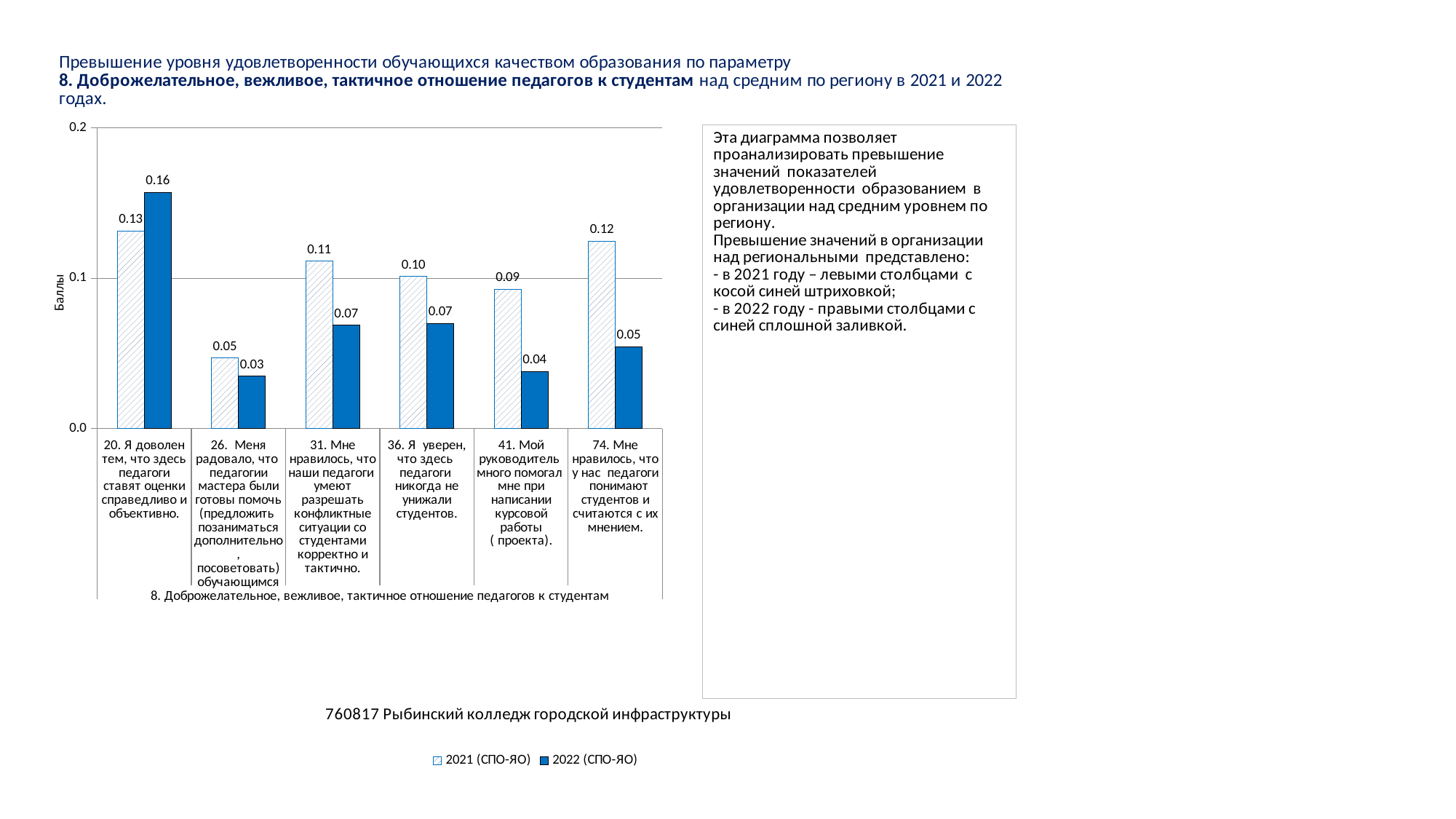
How many categories are shown on the x axis of the chart? 6 What is the 2022 (СПО-ЯО) value for category 41 ("Мой руководитель много помогал мне при написании курсовой работы")? 0.04 What is the 2022 (СПО-ЯО) value for category 74 ("Мне нравилось, что у нас педагоги понимают студентов и считаются с их мнением")? 0.05 What is the 2021 (СПО-ЯО) value for category 20 ("Я доволен тем, что здесь педагоги ставят оценки справедливо и объективно")? 0.13 What is the difference between the 2022 and 2021 values for category 20? 0.03 For category 31 ("Мне нравилось, что наши педагоги умеют разрешать конфликтные ситуации"), which is larger: the 2021 value or the 2022 value? 2021 How many series does the legend list? 2 What type of chart is shown on the slide? Bar chart Which category has the lowest 2021 (СПО-ЯО) value? 26. Меня радовало, что педагоги мастера были готовы помочь обучающимся Which category has the highest 2022 (СПО-ЯО) value? 20. Я доволен тем, что здесь педагоги ставят оценки справедливо и объективно. What is the label of the vertical axis? Баллы What is the difference between the 2021 and 2022 values for category 74? 0.07